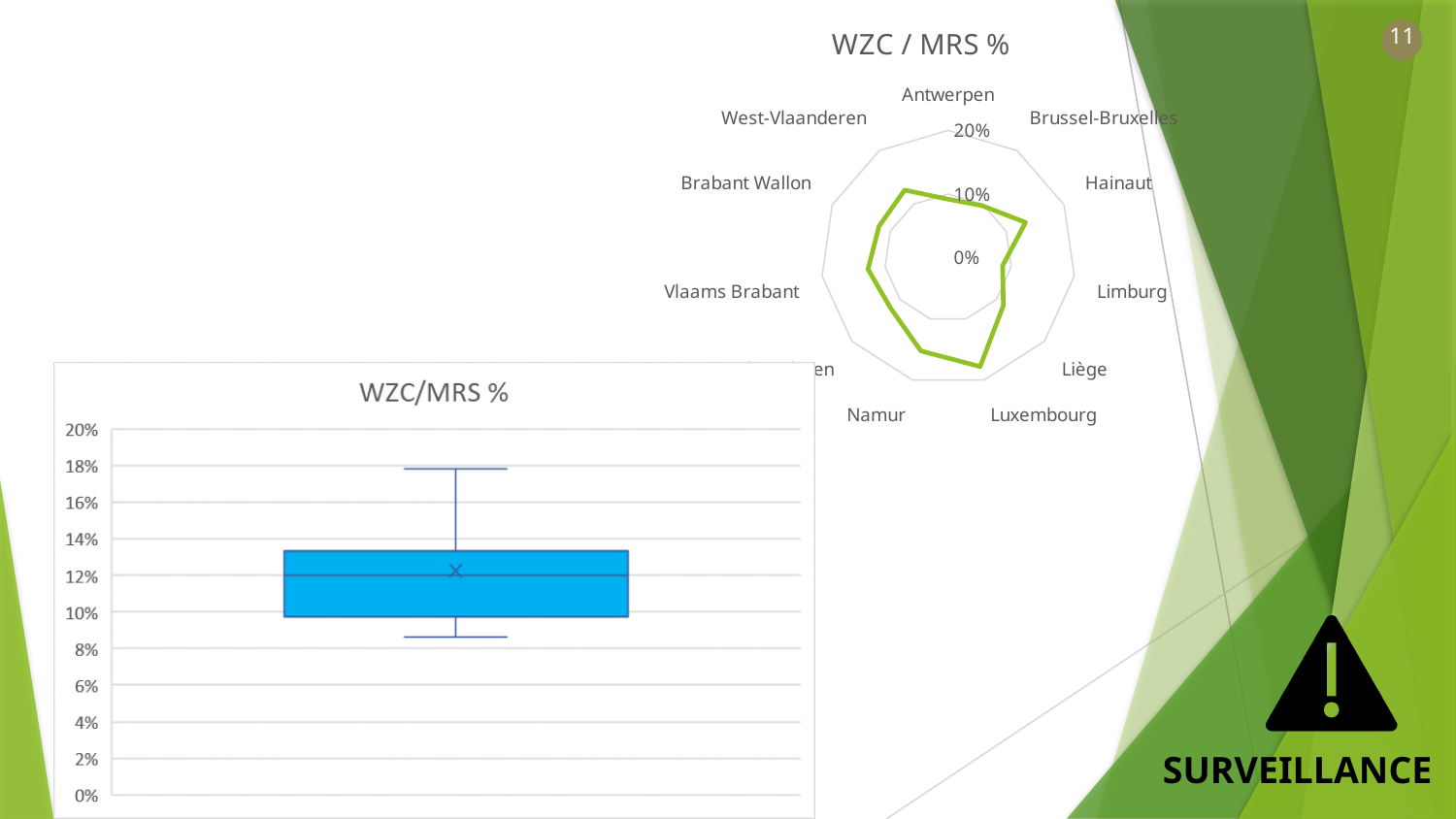
In the box plot, is the bottom of the lower whisker greater or less than 10%? less In the box plot, is the top of the upper whisker greater or less than 16%? greater In the radar chart, is the value for Vlaams Brabant greater or less than 10%? greater What is the title of the radar chart in the top right? WZC / MRS % In the radar chart, which is larger, the value for Luxembourg or the value for Limburg? Luxembourg What kind of chart is the chart in the bottom left of the slide? box plot How many boxes are plotted in the box plot in the bottom left? 1 In the radar chart, what is the highest value shown on the radial axis? 20% What kind of chart is the chart in the top right of the slide? radar chart